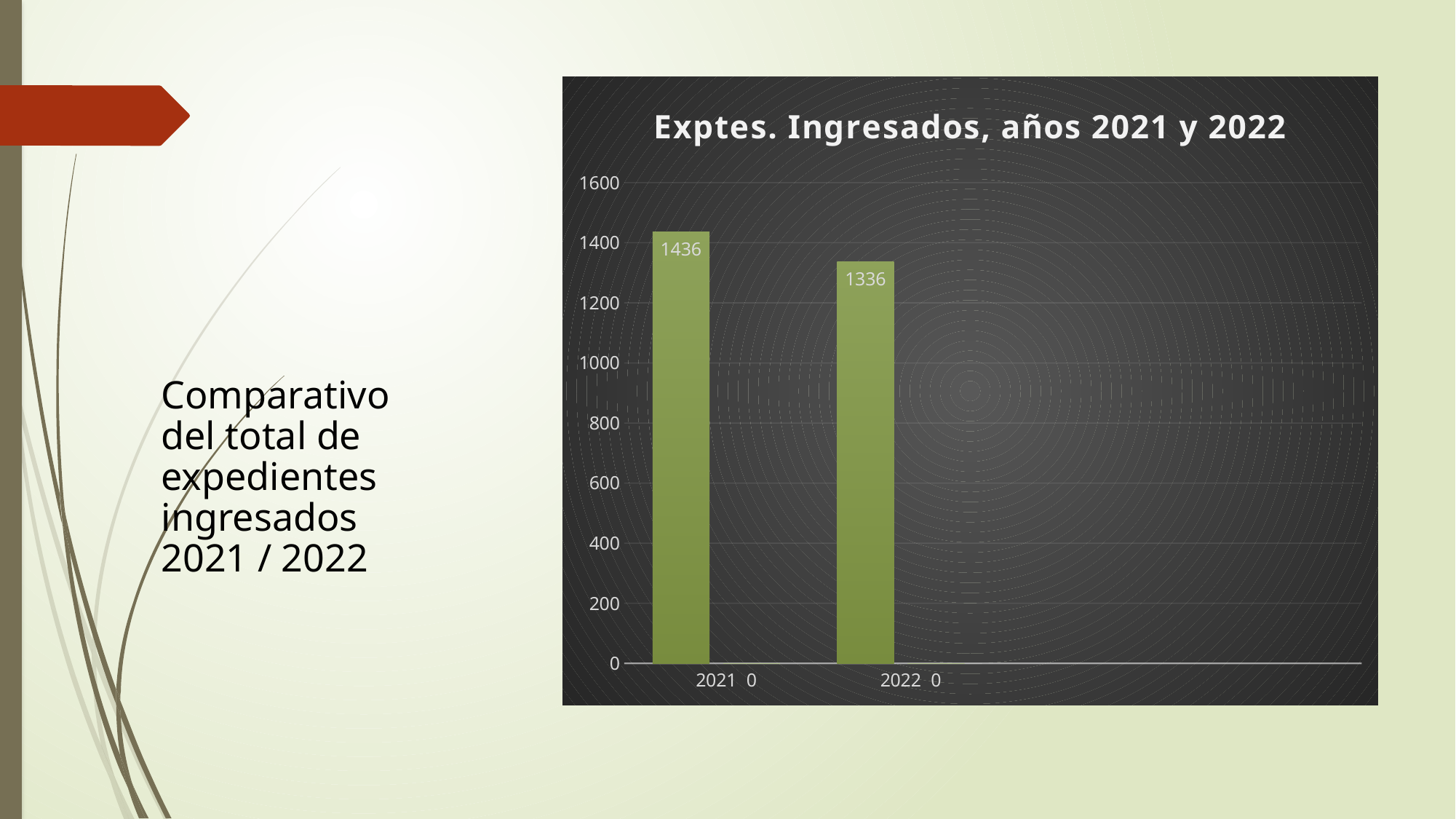
What kind of chart is shown on the slide? bar chart Which year has the highest value? 2021 Is the value for 2022 greater or less than 1400? less Which year has the lowest value? 2022 What is the value for 2021? 1436 Is the value for 2021 greater or less than 1400? greater Do the values rise or fall from 2021 to 2022? fall What is the title of the chart? Exptes. Ingresados, años 2021 y 2022 What is the value for 2022? 1336 Which is larger, the value for 2021 or the value for 2022? 2021 How many bars are shown in the chart? 2 What is the difference between the values for 2021 and 2022? 100